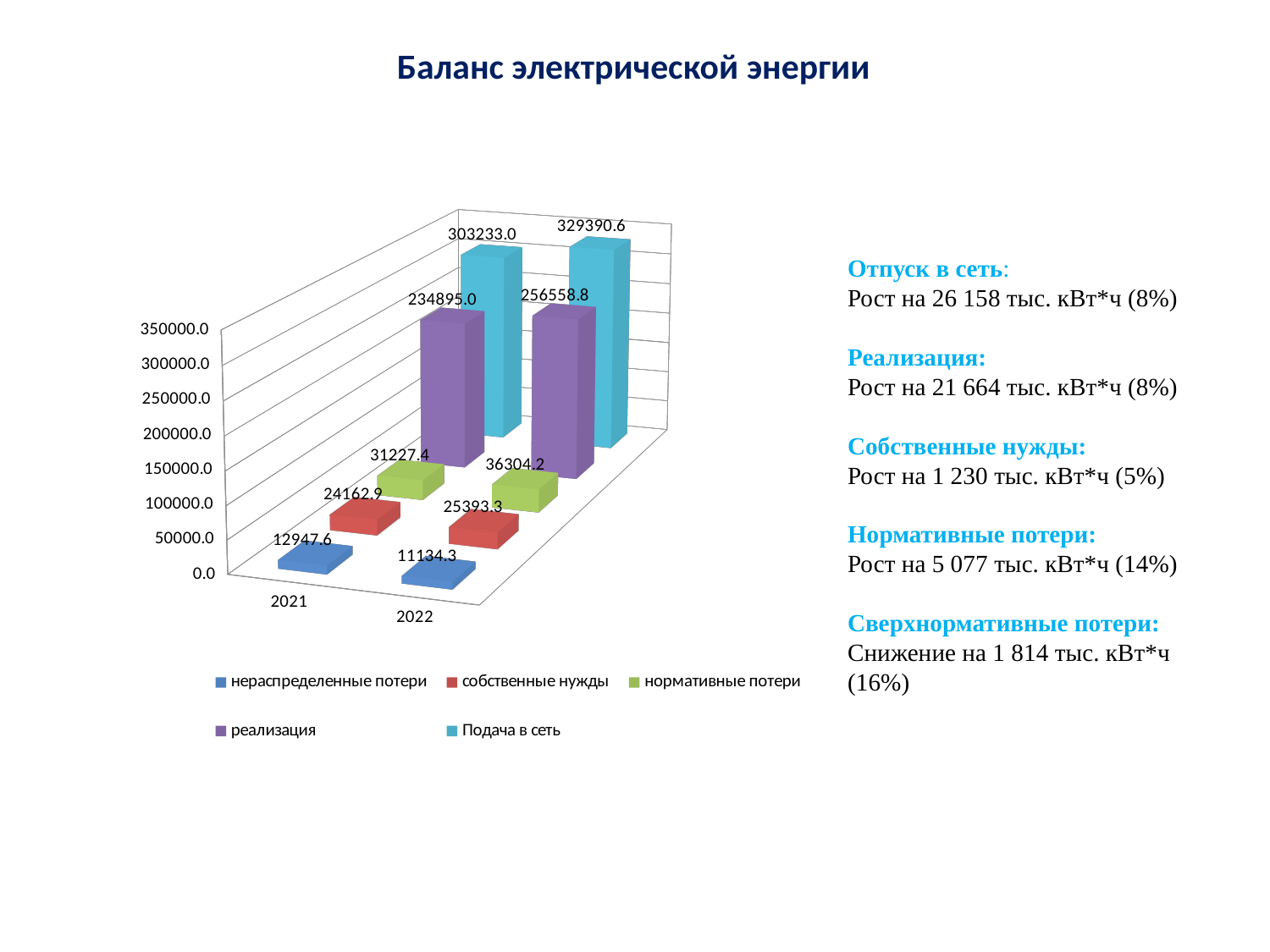
What is the value for нераспределенные потери in 2021? 12947.6 What is the difference between the реализация values for 2022 and 2021? 21663.8 Which series has the highest value in 2022? Подача в сеть How many series does the legend list? 5 What is the difference between the Подача в сеть values for 2022 and 2021? 26157.6 Which series has the lowest value in 2021? нераспределенные потери What is the value for Подача в сеть in 2022? 329390.6 Does the value for собственные нужды rise or fall from 2021 to 2022? rise Which is larger: нераспределенные потери in 2021 or in 2022? 2021 What is the value for нормативные потери in 2022? 36304.2 What is the value for реализация in 2021? 234895.0 What kind of chart is shown on the slide? bar chart